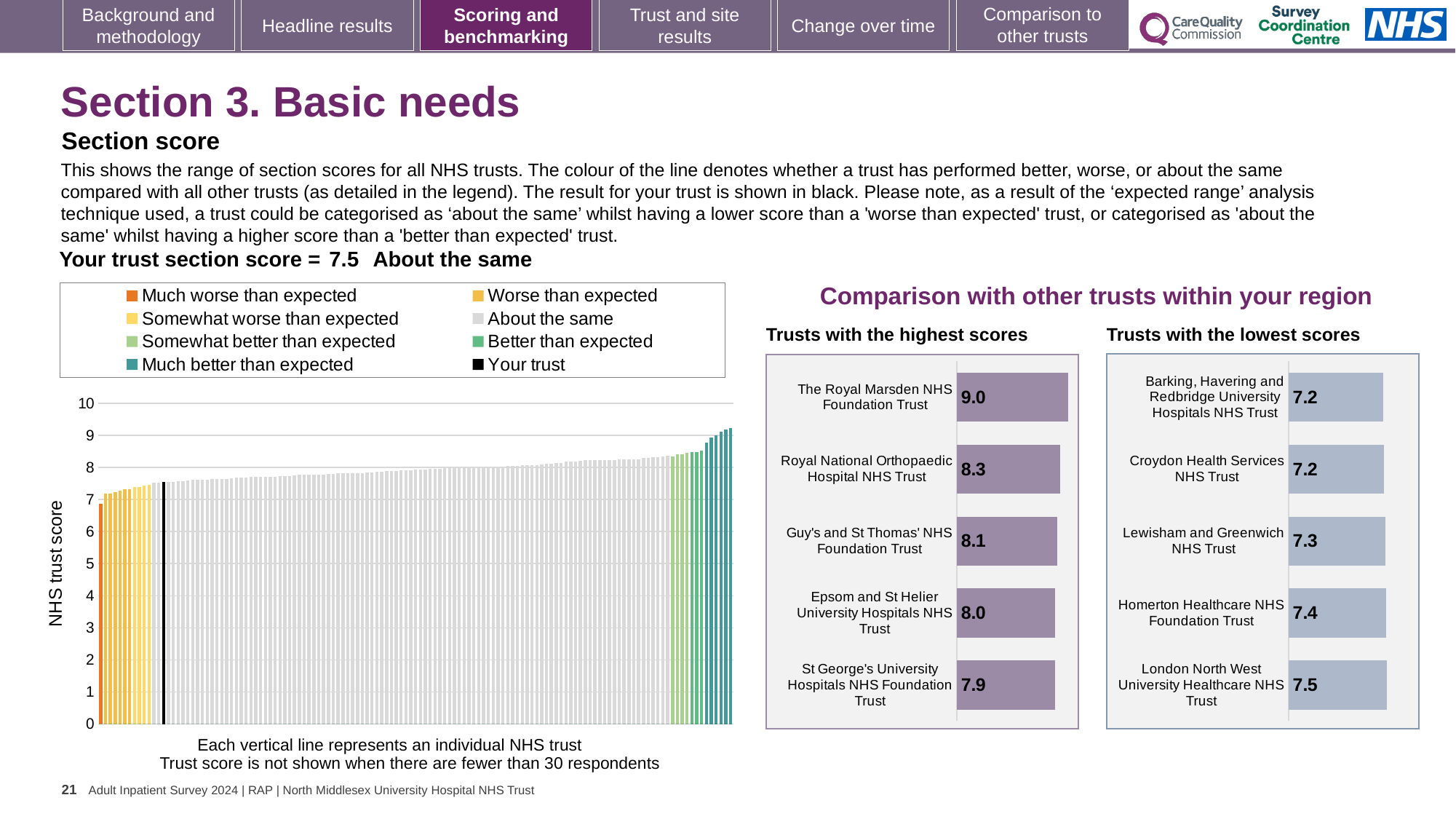
How many trusts are shown in the 'Trusts with the highest scores' chart? 5 In the 'Trusts with the highest scores' chart, which trust has the lowest score? St George's University Hospitals NHS Foundation Trust In the 'Trusts with the lowest scores' chart, what is the score for Lewisham and Greenwich NHS Trust? 7.3 In the 'Trusts with the highest scores' chart, what is the difference between the scores of The Royal Marsden NHS Foundation Trust and St George's University Hospitals NHS Foundation Trust? 1.1 In the 'Trusts with the highest scores' chart, which trust has the highest score? The Royal Marsden NHS Foundation Trust How many entries does the legend of the large chart on the left list? 8 What kind of chart is the large chart on the left with the 'NHS trust score' axis? Bar chart In the large chart on the left, do the trust scores rise or fall from left to right? Rise In the 'Trusts with the highest scores' chart, what is the score for The Royal Marsden NHS Foundation Trust? 9.0 What is the section score for your trust shown above the large chart on the left? 7.5 In the large chart on the left, is the value of the leftmost (orange) bar greater or less than 6? greater In the 'Trusts with the lowest scores' chart, which has the larger score: Homerton Healthcare NHS Foundation Trust or Croydon Health Services NHS Trust? Homerton Healthcare NHS Foundation Trust